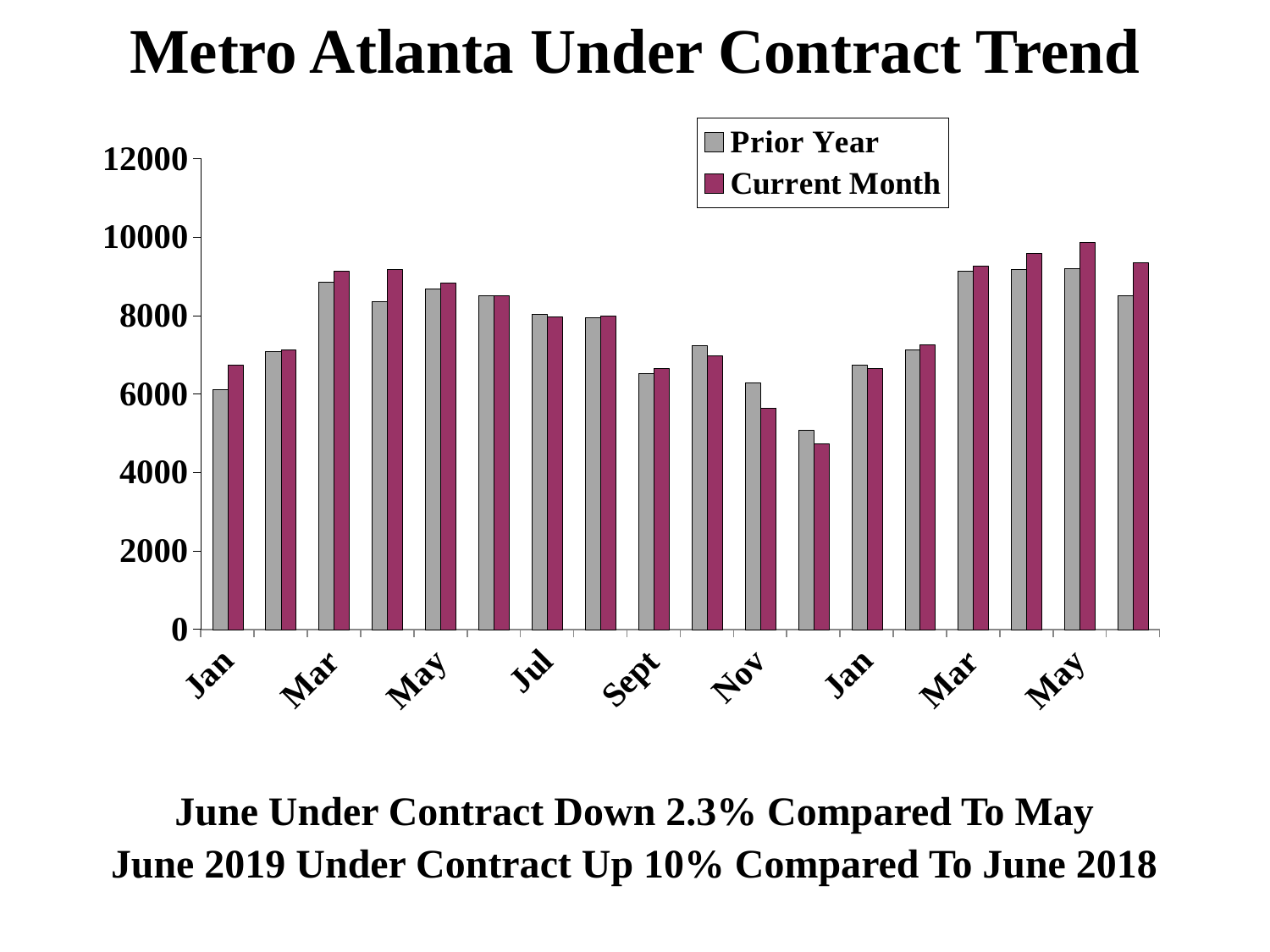
Is the Current Month value for Nov greater or less than 6000? less Is the Current Month value for the second May greater or less than 8000? greater How many monthly groups of bars are plotted on the chart? 18 Is the Prior Year value for the first Jan greater or less than 4000? greater What are the two series named in the legend? Prior Year and Current Month How many series does the legend list? 2 What kind of chart is shown on the slide? Bar chart What is the title of the chart? Metro Atlanta Under Contract Trend For Nov, which series has the larger value, Prior Year or Current Month? Prior Year Do the Current Month values rise or fall from Jul to Nov? fall For the first Jan, which series has the larger value, Prior Year or Current Month? Current Month